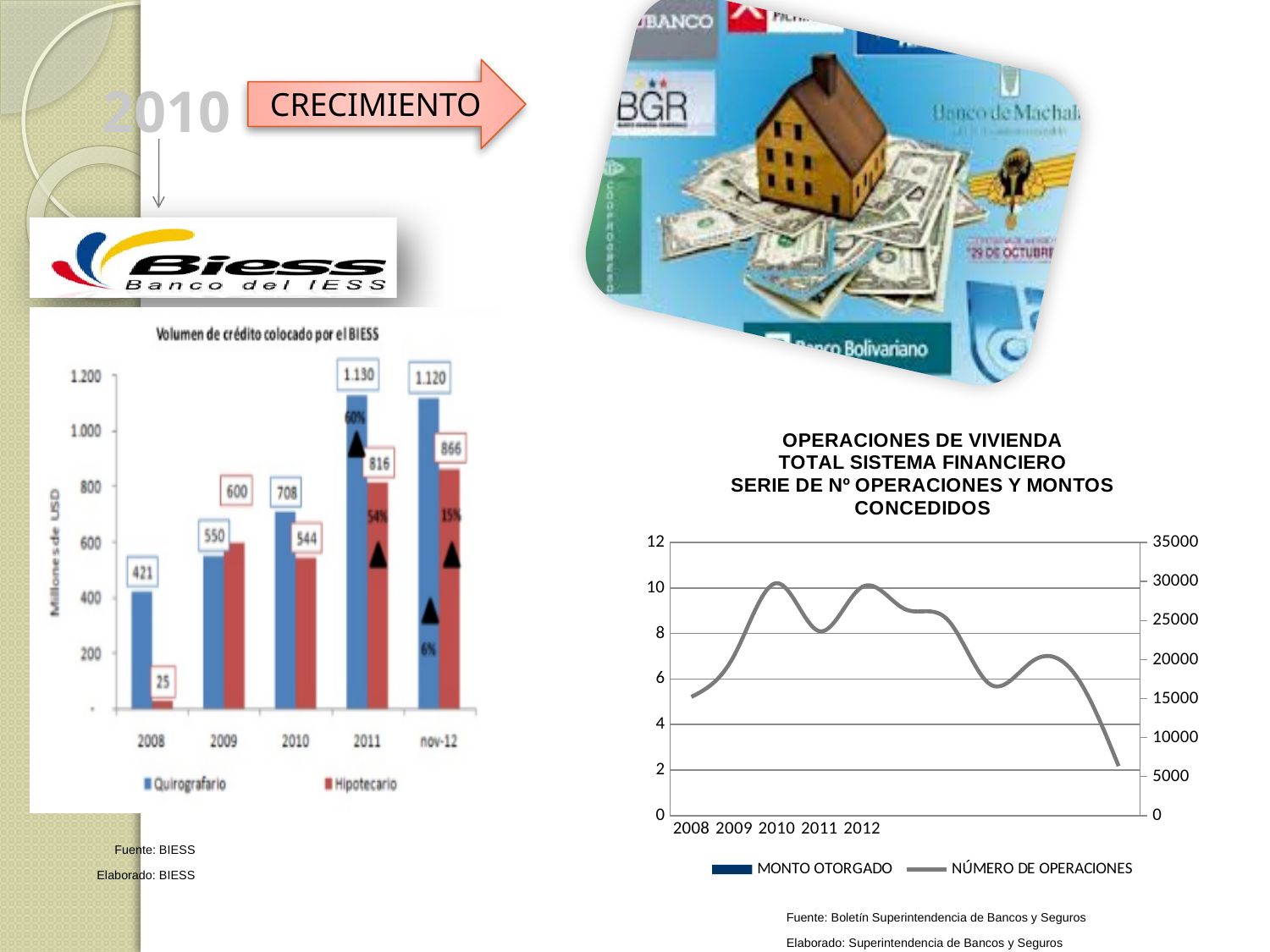
In the chart titled 'OPERACIONES DE VIVIENDA TOTAL SISTEMA FINANCIERO', what is the name of the series drawn as a line? NÚMERO DE OPERACIONES In the chart titled 'Volumen de crédito colocado por el BIESS', how many periods are shown on the x axis? 5 In the chart titled 'Volumen de crédito colocado por el BIESS', what is the Hipotecario value for 2008? 25 In the chart titled 'Volumen de crédito colocado por el BIESS', which year has the lowest Hipotecario value? 2008 In the chart titled 'OPERACIONES DE VIVIENDA TOTAL SISTEMA FINANCIERO', how many series does the legend list? 2 In the chart titled 'Volumen de crédito colocado por el BIESS', which is larger in 2009: Quirografario or Hipotecario? Hipotecario What kind of chart is the one titled 'Volumen de crédito colocado por el BIESS'? Bar chart In the chart titled 'Volumen de crédito colocado por el BIESS', what is the Hipotecario value for nov-12? 866 In the chart titled 'Volumen de crédito colocado por el BIESS', how many series does the legend list? 2 In the chart titled 'Volumen de crédito colocado por el BIESS', what is the Quirografario value for 2011? 1.130 In the chart titled 'Volumen de crédito colocado por el BIESS', which year has the highest Quirografario value? 2011 In the chart titled 'Volumen de crédito colocado por el BIESS', what is the difference between the Quirografario and Hipotecario values in 2010? 164